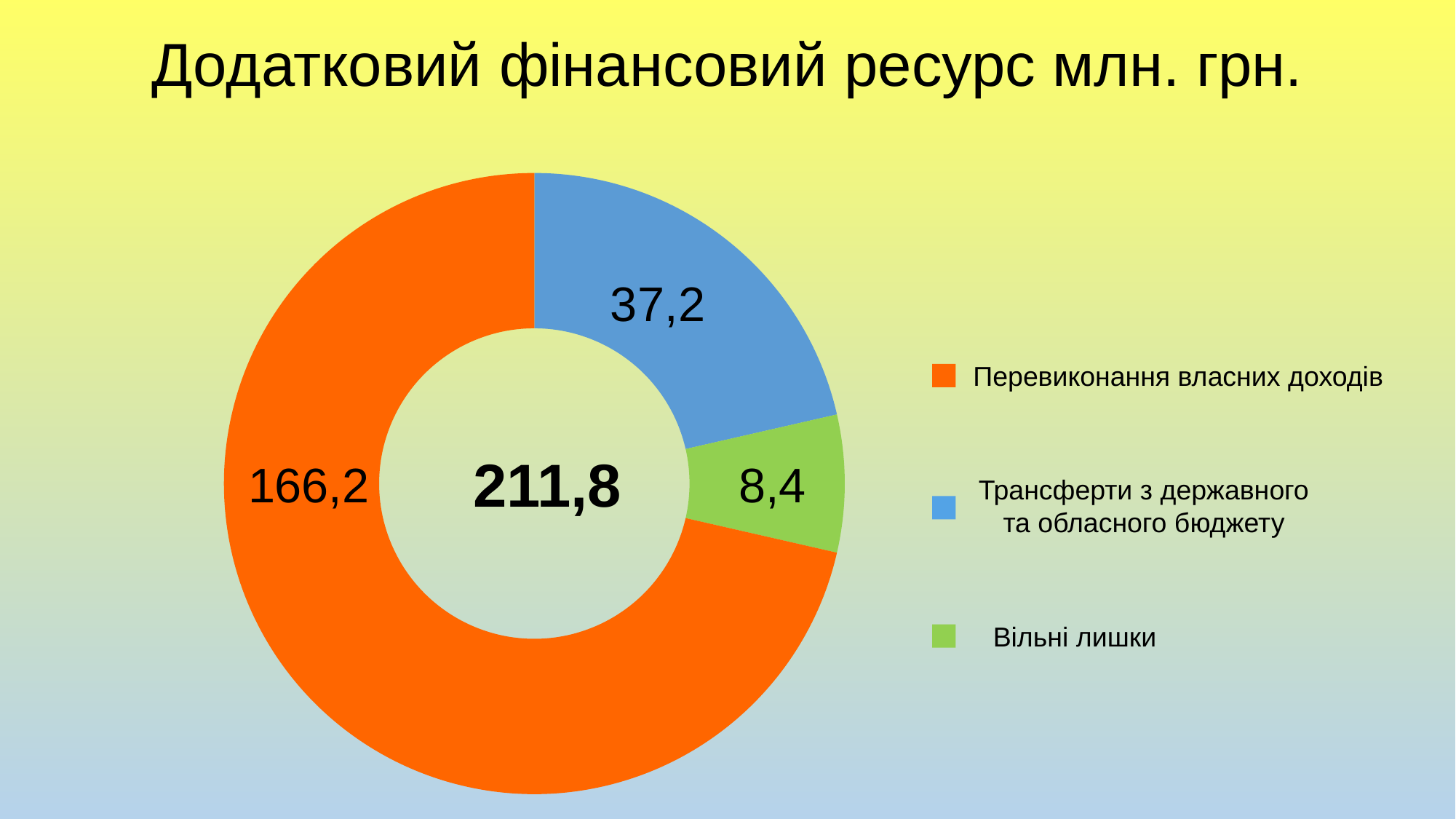
Which category has the largest slice? Перевиконання власних доходів What is the total shown in the centre of the chart? 211,8 What is the value for Вільні лишки? 8,4 What is the difference between Перевиконання власних доходів and Трансферти з державного та обласного бюджету? 129,0 What is the value for Перевиконання власних доходів? 166,2 How many categories does the chart show? 3 Which category has the smallest slice? Вільні лишки Which is larger: Трансферти з державного та обласного бюджету or Вільні лишки? Трансферти з державного та обласного бюджету What is the difference between Трансферти з державного та обласного бюджету and Вільні лишки? 28,8 What is the value for Трансферти з державного та обласного бюджету? 37,2 What kind of chart is shown on the slide? doughnut chart What is the title of the chart? Додатковий фінансовий ресурс млн. грн.